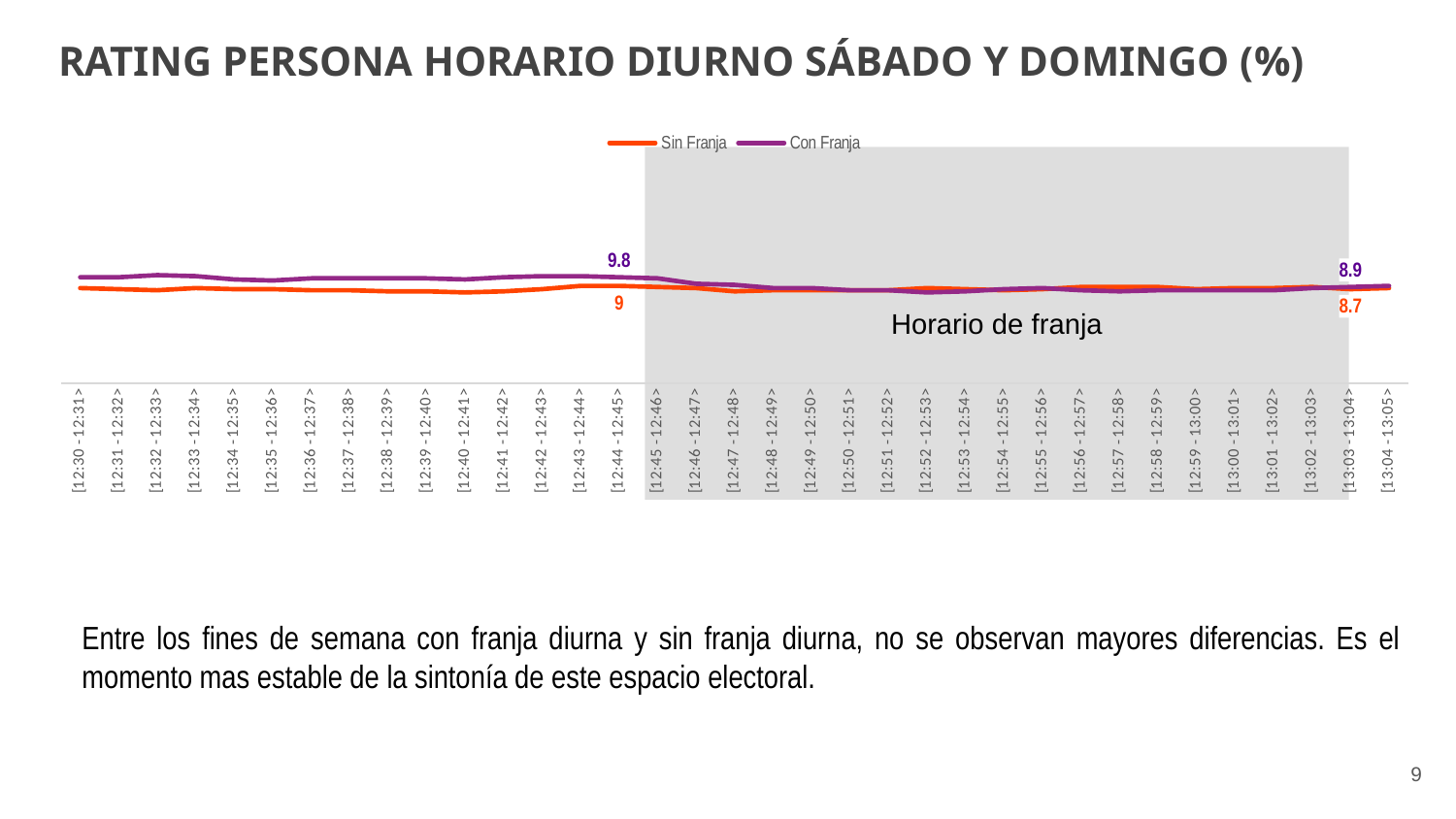
Which series has the higher value at [12:44 - 12:45>, Sin Franja or Con Franja? Con Franja What is the value of Sin Franja at [13:03 - 13:04>? 8.7 What type of chart is shown on the slide? line chart What are the two series named in the legend? Sin Franja and Con Franja What is the value of Con Franja at [12:44 - 12:45>? 9.8 How many time intervals are shown on the x axis? 35 What is the difference between Con Franja and Sin Franja at [13:03 - 13:04>? 0.2 What is the value of Sin Franja at [12:44 - 12:45>? 9 What is the value of Con Franja at [13:03 - 13:04>? 8.9 What label is written inside the shaded area of the chart? Horario de franja How many series does the legend list? 2 What is the difference between Con Franja and Sin Franja at [12:44 - 12:45>? 0.8